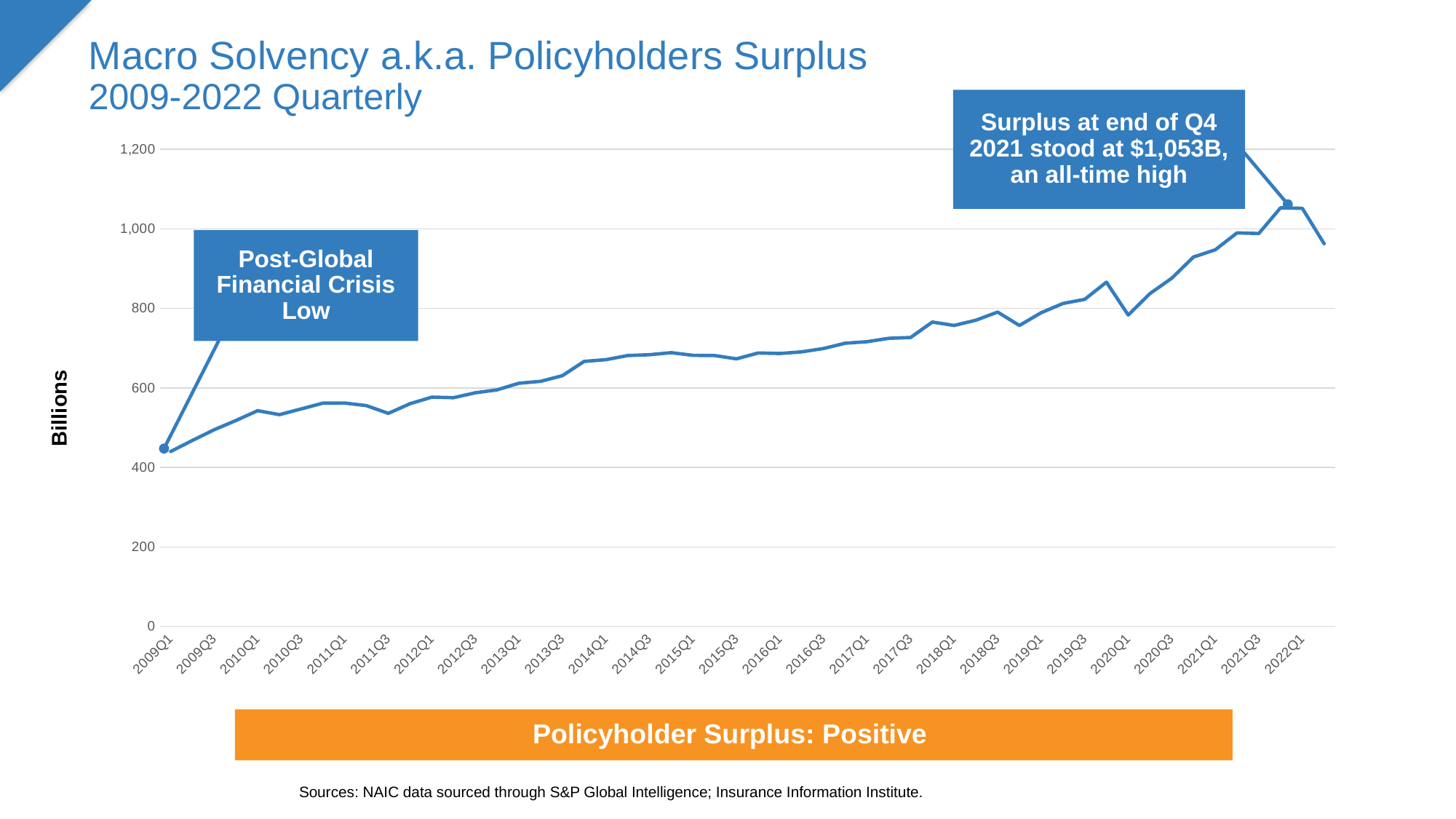
According to the annotation, what was the policyholder surplus at the end of Q4 2021? $1,053B What is the label on the vertical axis? Billions Which is larger, the value for 2021Q3 or the value for 2020Q1? 2021Q3 Is the value for 2021Q1 greater or less than 1,000? less Is the value for 2009Q1 greater or less than 600? less According to the annotation, when did the surplus reach its all-time high? Q4 2021 Is the value for 2014Q1 greater or less than 600? greater Does the policyholder surplus generally rise or fall from 2009 to 2021? rise What kind of chart is shown on the slide? line chart What is the highest value shown on the vertical axis? 1,200 Which quarter is marked as the Post-Global Financial Crisis Low on the chart? 2009Q1